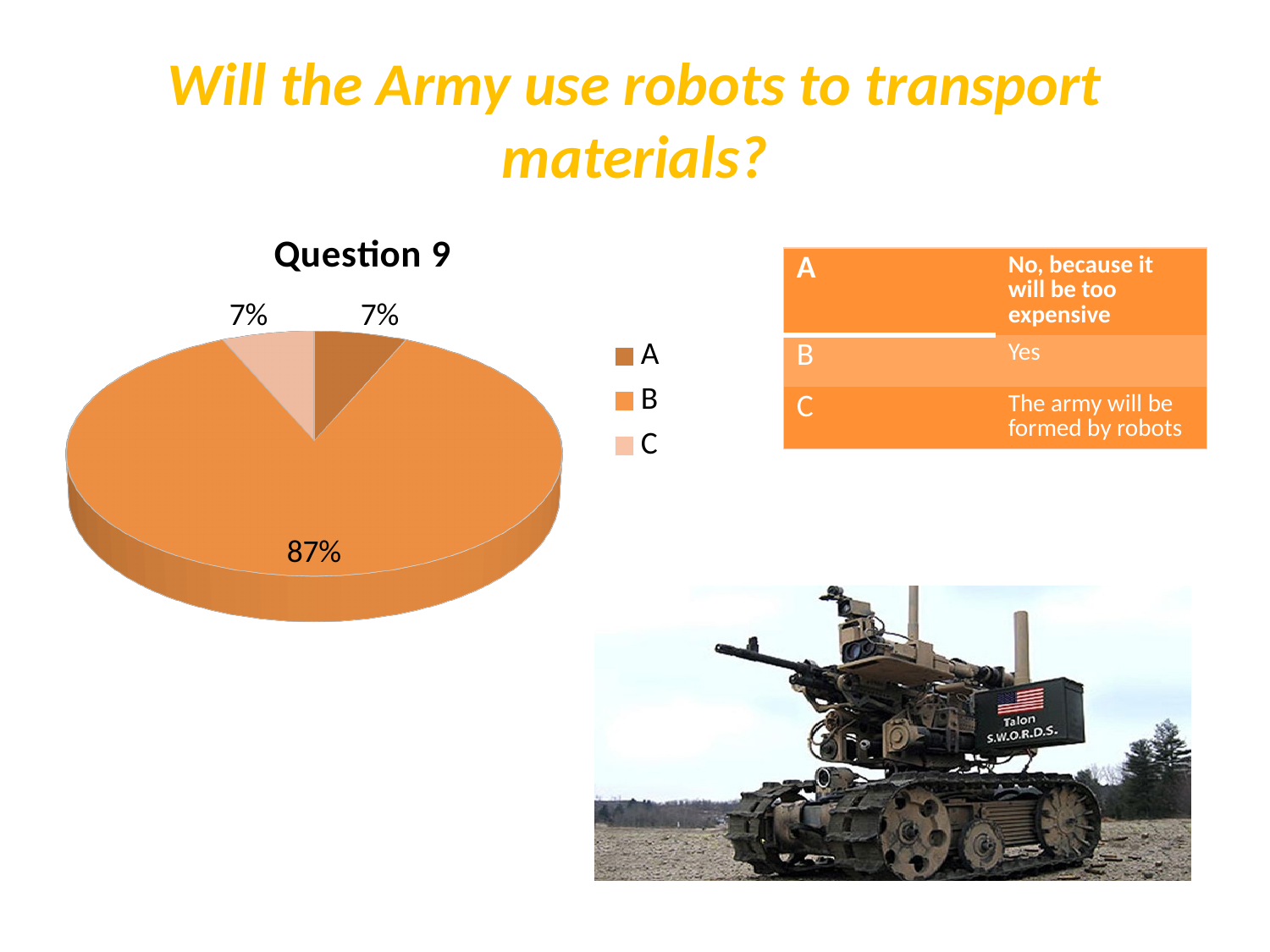
What percentage of the pie does slice C represent? 7% What percentage of the pie does slice A represent? 7% What percentage of the pie does slice B represent? 87% What is the title of the chart? Question 9 Which slice is the largest in the pie chart? B What type of chart is shown on the slide? pie chart How many entries does the legend list? 3 Which legend entry is shown in the lightest colour? C How many slices does the pie chart have? 3 Which is larger, slice B or slice C? B What is the difference in percentage points between slice B and slice A? 80 What is the combined share of slices A and C? 14%